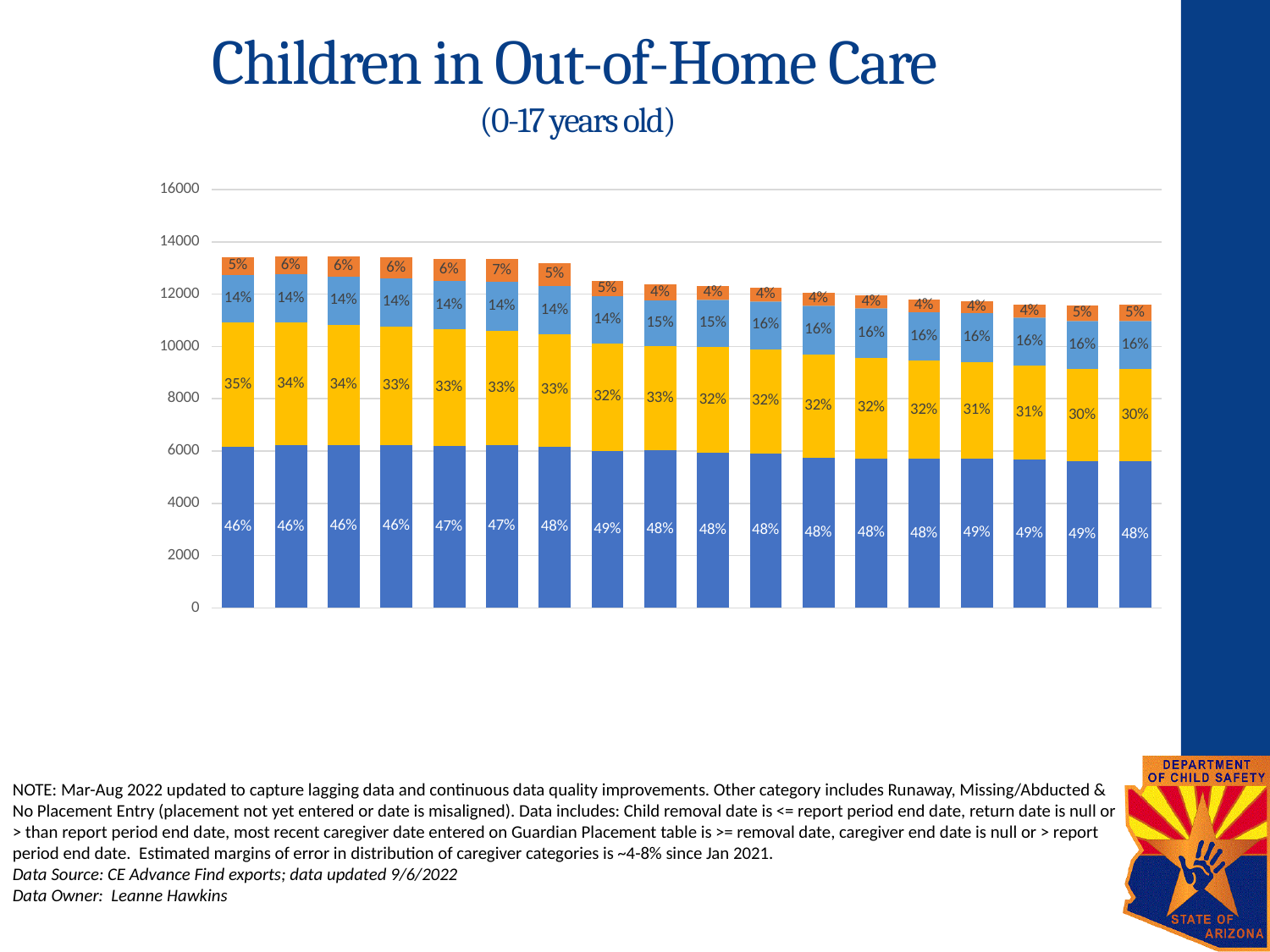
What is the difference between the yellow segment label of the first bar (35%) and that of the last bar (30%)? 5 percentage points Do the total bar heights generally rise or fall from left to right? fall What kind of chart is shown on the slide? stacked bar chart How many stacked segments make up each bar? 4 What is the percentage label on the yellow segment of the last bar on the right? 30% What is the percentage label on the bottom (dark blue) segment of the last bar on the right? 48% Which is larger, the yellow segment label of the first bar or the yellow segment label of the last bar? first bar What is the highest percentage label shown on any top (orange) segment? 7% What is the percentage label on the bottom (dark blue) segment of the first bar on the left? 46% What is the percentage label on the top (orange) segment of the first bar on the left? 5% Is the total height of the first bar on the left greater or less than 12000? greater How many bars are plotted in the chart? 18